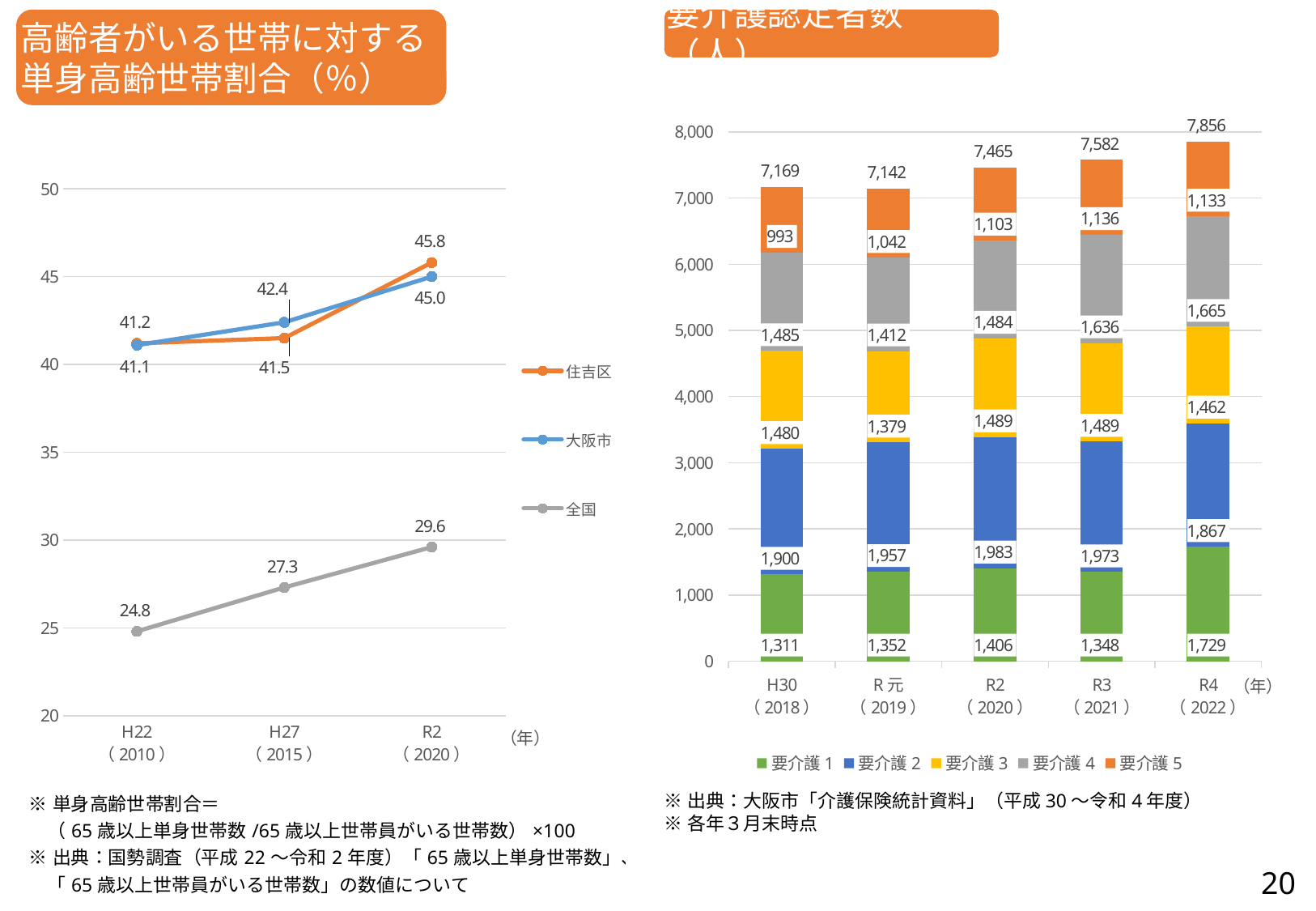
In the right chart (要介護認定者数), which year has the lowest total? R元（2019） In the left chart (高齢者がいる世帯に対する単身高齢世帯割合), how many series does the legend list? 3 In the left chart (高齢者がいる世帯に対する単身高齢世帯割合), what is the value for 大阪市 in H27 (2015)? 42.4 What kind of chart is the right chart (要介護認定者数)? stacked bar chart In the right chart (要介護認定者数), what is the total for R4 (2022)? 7,856 In the left chart (高齢者がいる世帯に対する単身高齢世帯割合), what is the difference between 住吉区 and 大阪市 in R2 (2020)? 0.8 In the left chart (高齢者がいる世帯に対する単身高齢世帯割合), what is the value for 住吉区 in R2 (2020)? 45.8 In the right chart (要介護認定者数), how many years are shown on the x axis? 5 In the left chart (高齢者がいる世帯に対する単身高齢世帯割合), what is the value for 全国 in H22 (2010)? 24.8 In the right chart (要介護認定者数), what is the value of 要介護1 in R4 (2022)? 1,729 In the left chart (高齢者がいる世帯に対する単身高齢世帯割合), does the 全国 line rise or fall from H22 to R2? rise In the right chart (要介護認定者数), what is the difference between the totals for R4 (2022) and H30 (2018)? 687